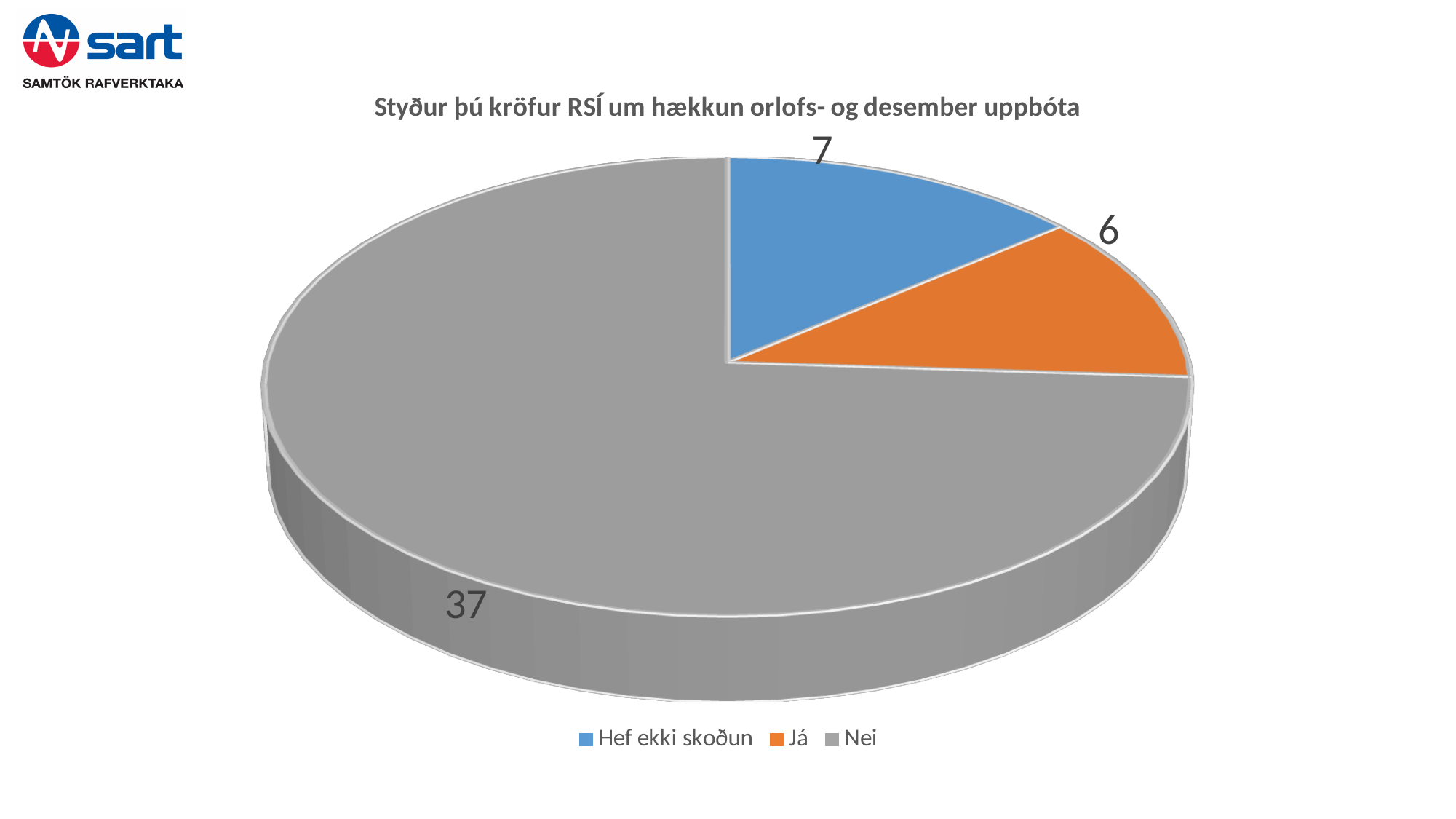
What is the title of the chart? Styður þú kröfur RSÍ um hækkun orlofs- og desember uppbóta What type of chart is shown on the slide? Pie chart What is the difference between the values for "Hef ekki skoðun" and "Já"? 1 What is the total of all slices in the pie chart? 50 Which is larger, the value for "Já" or the value for "Nei"? Nei What is the value for "Nei"? 37 What is the difference between the values for "Nei" and "Hef ekki skoðun"? 30 Which category has the largest slice? Nei What is the value for "Já"? 6 What is the value for "Hef ekki skoðun"? 7 How many categories does the pie chart have? 3 Which category has the smallest slice? Já